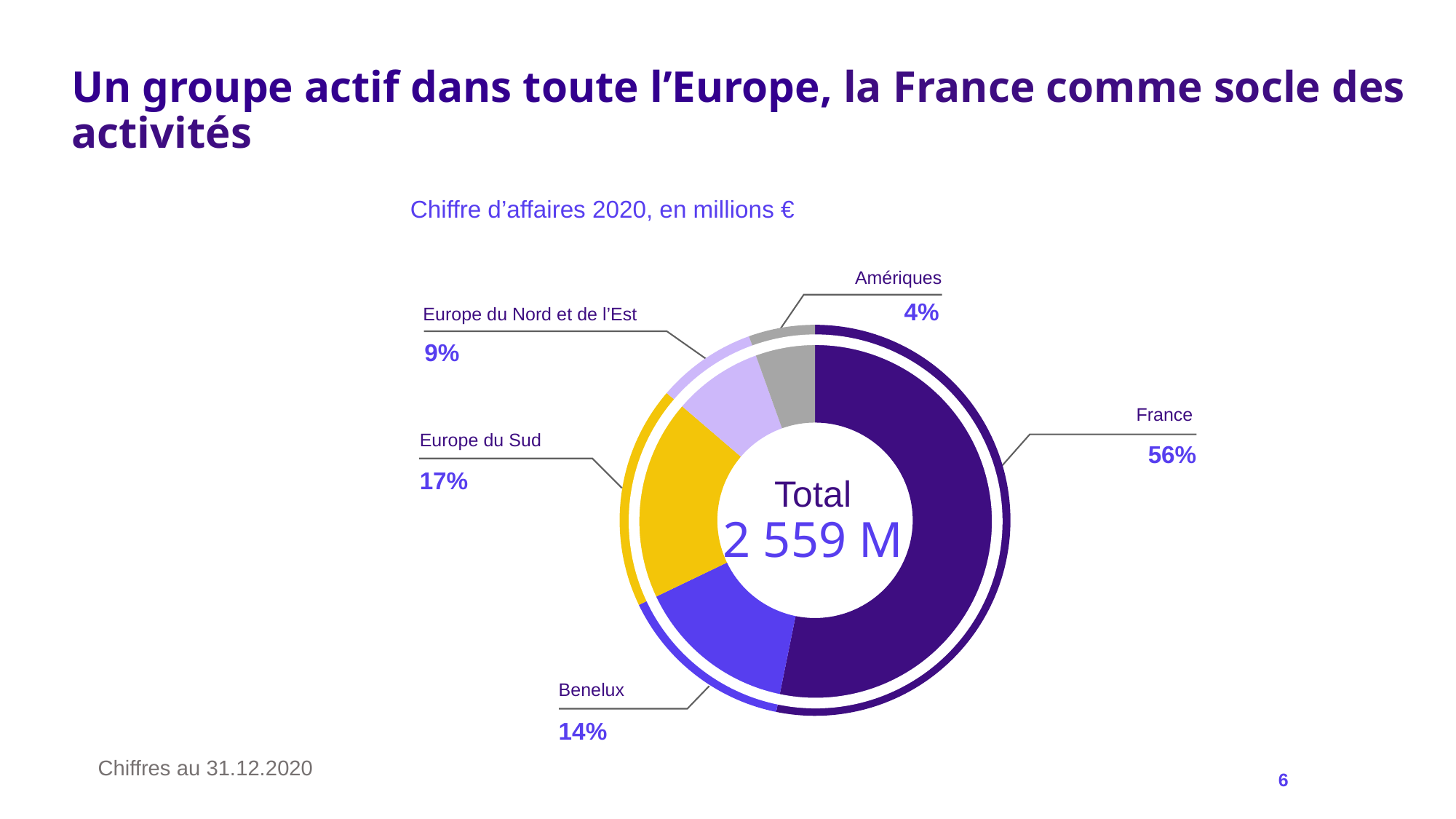
What total revenue is shown in the centre of the chart? 2 559 M What kind of chart is shown on the slide? Pie chart (donut) How many regions are shown in the chart? 5 What share of 2020 revenue does Amériques represent? 4% Which region has the largest share of 2020 revenue? France What share of 2020 revenue does Europe du Nord et de l'Est represent? 9% Which region has the smallest share of 2020 revenue? Amériques Which has a larger share of 2020 revenue, Europe du Nord et de l'Est or Amériques? Europe du Nord et de l'Est What share of 2020 revenue does France represent? 56% What is the difference in percentage points between the shares of Europe du Sud and Benelux? 3 percentage points